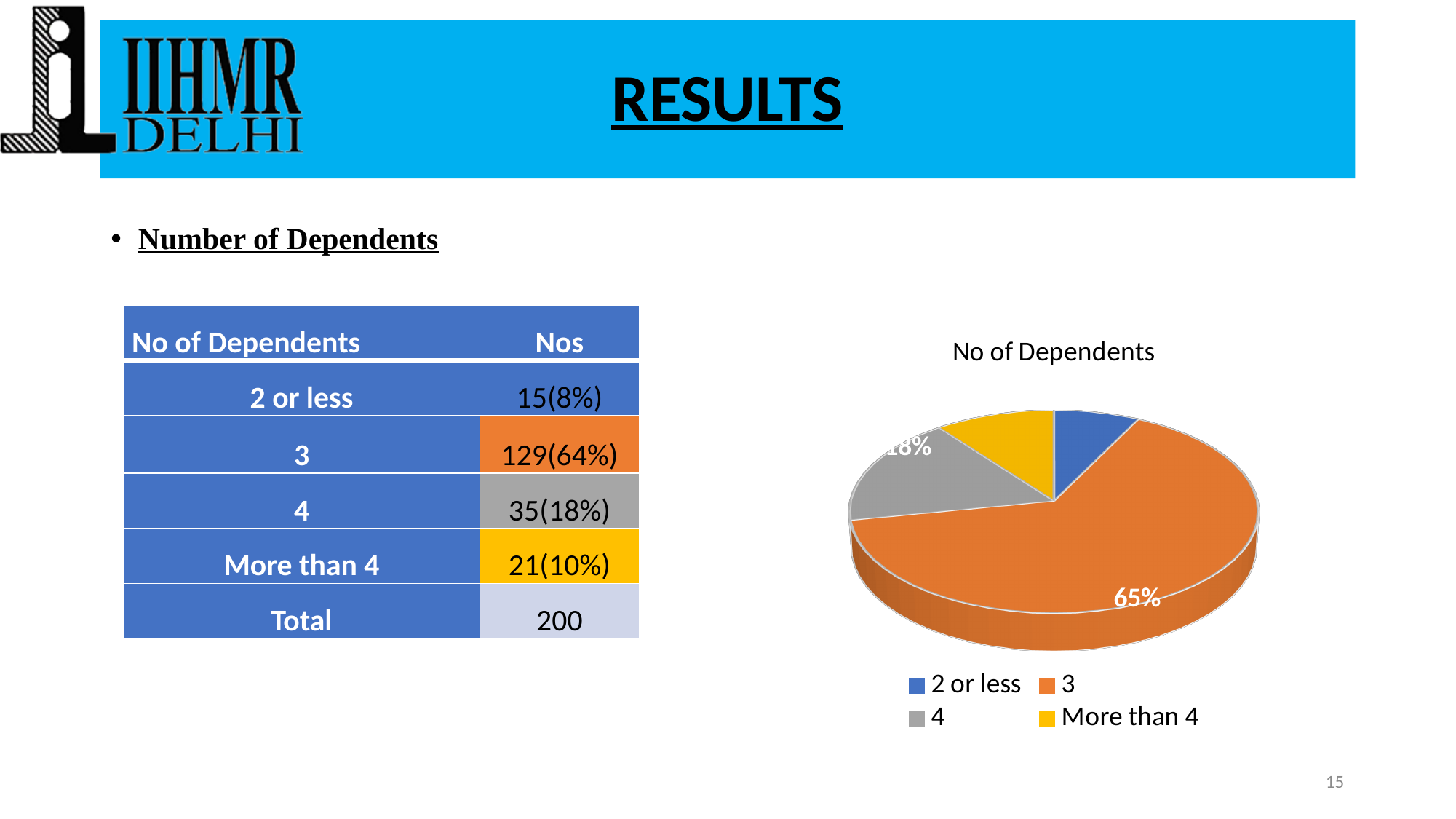
What colour is the slice for 'More than 4' in the pie chart? yellow Which category has the largest slice in the pie chart? 3 How many slices does the pie chart have? 4 What percentage label is shown on the slice for '4' in the pie chart? 18% What kind of chart is shown on the slide? pie chart In the pie chart, which slice is larger: '4' or 'More than 4'? 4 What percentage label is shown on the slice for '3' in the pie chart? 65% What is the title of the pie chart? No of Dependents Which category has the smallest slice in the pie chart? 2 or less How many categories does the legend of the pie chart list? 4 What is the difference between the labelled shares of '3' and '4' in the pie chart? 47% In the pie chart, which slice is larger: '3' or '4'? 3